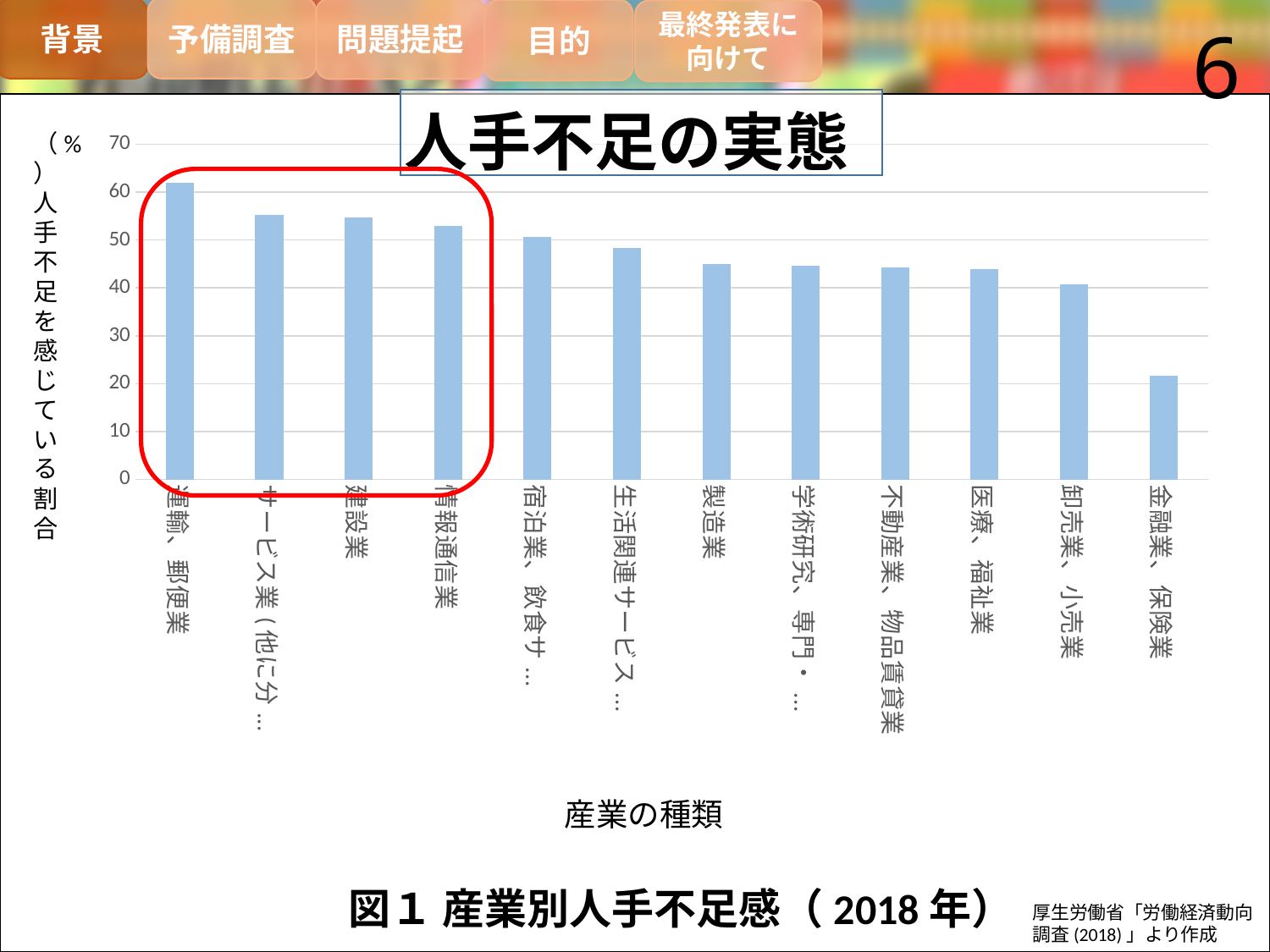
How many industry categories are plotted on the x axis? 12 Is the value for 金融業、保険業 greater or less than 30? less Which industry has the highest bar? 運輸、郵便業 Is the value for 運輸、郵便業 greater or less than 60? greater What kind of chart is shown on the slide? bar chart Which is larger, the value for 運輸、郵便業 or the value for 製造業? 運輸、郵便業 What is the label of the x axis? 産業の種類 Which industry has the lowest bar? 金融業、保険業 Do the bar values rise or fall from left to right along the x axis? fall Is the value for 卸売業、小売業 greater or less than 50? less Which is larger, the value for 建設業 or the value for 金融業、保険業? 建設業